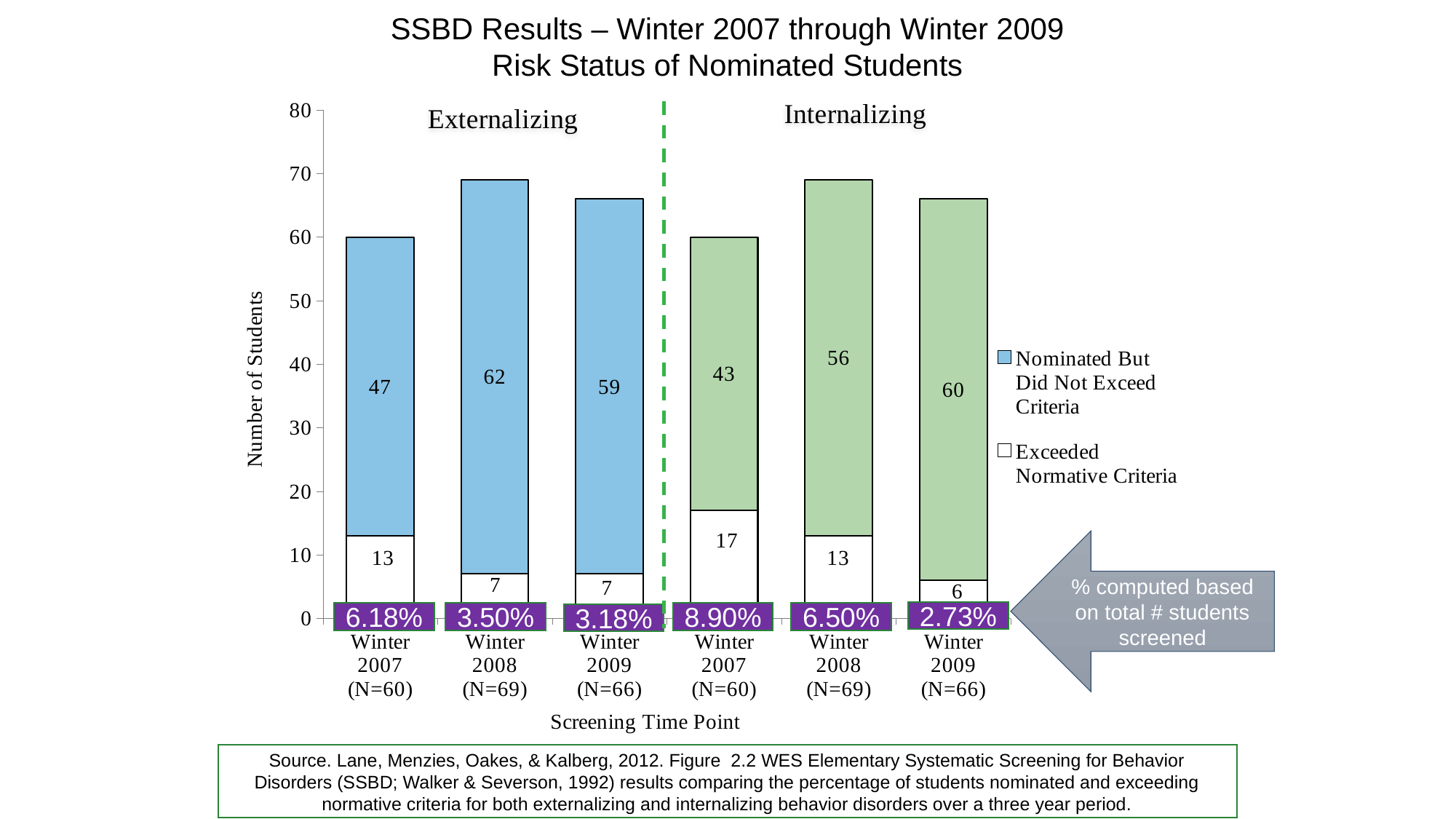
Which screening time point has the highest number of students who exceeded normative criteria? Internalizing Winter 2007 How many bars are plotted in the chart? 6 What percentage is shown below the Internalizing Winter 2007 bar? 8.90% How many students were nominated but did not exceed criteria for Internalizing in Winter 2008? 56 What is the difference between the number of students nominated but not exceeding criteria for Externalizing Winter 2008 and Externalizing Winter 2007? 15 What is the total height of the Externalizing Winter 2008 stacked bar? 69 Which is larger: the number of students exceeding normative criteria for Internalizing Winter 2008 or for Externalizing Winter 2009? Internalizing Winter 2008 What kind of chart is shown on the slide? Stacked bar chart How many students exceeded normative criteria for Externalizing in Winter 2007? 13 What is the label of the y axis? Number of Students How many series does the legend list? 2 Which screening time point has the lowest number of students who exceeded normative criteria? Internalizing Winter 2009